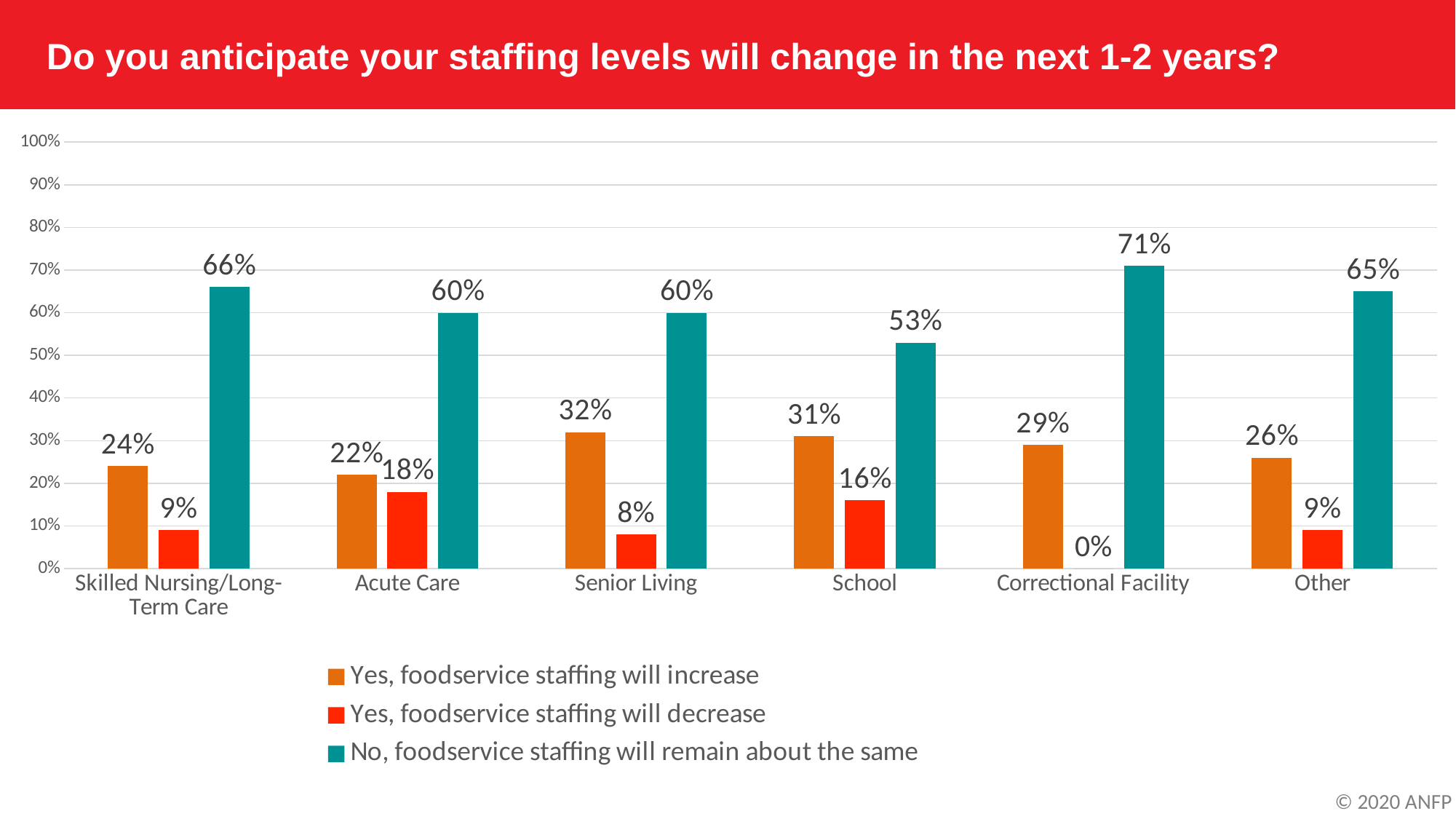
Which is larger: the 'will increase' value for School or for Other? School Which category has the lowest value for 'Yes, foodservice staffing will increase'? Acute Care What is the difference between the 'remain about the same' values for Correctional Facility and School? 18% What percentage of Skilled Nursing/Long-Term Care respondents said foodservice staffing will remain about the same? 66% What percentage of Correctional Facility respondents said foodservice staffing will decrease? 0% What kind of chart is shown on the slide? Bar chart How many categories are shown on the x axis? 6 What percentage of Senior Living respondents said foodservice staffing will increase? 32% How many series does the legend list? 3 Which category has the highest value for 'No, foodservice staffing will remain about the same'? Correctional Facility What percentage of Acute Care respondents said foodservice staffing will decrease? 18% Which colour represents 'Yes, foodservice staffing will decrease' in the legend? Red